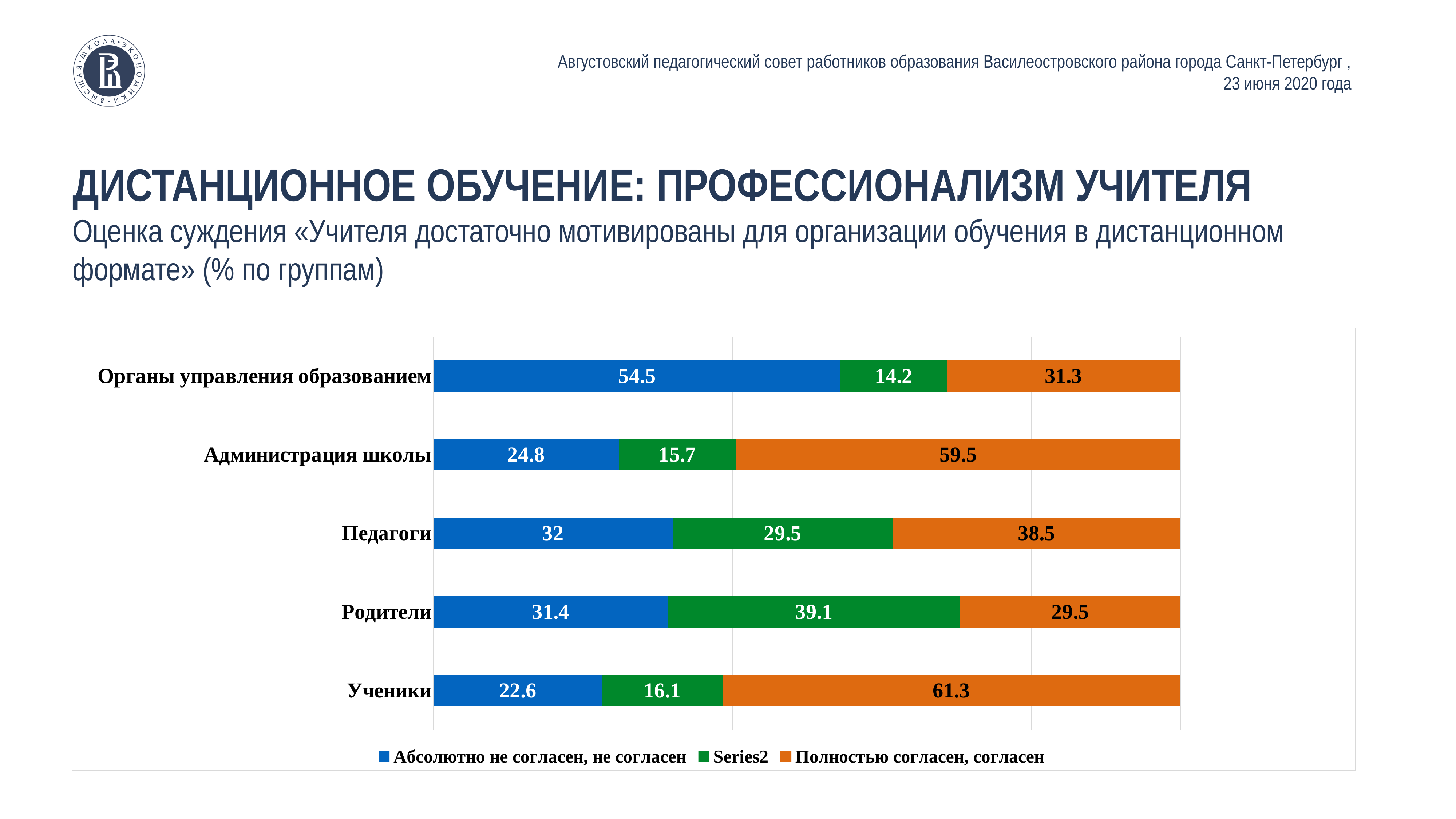
What is the label of the second (green) series in the legend? Series2 What is the Series2 value for Родители? 39.1 What is the value for Ученики in the series «Полностью согласен, согласен»? 61.3 Which group has the highest value in the series «Полностью согласен, согласен»? Ученики Which is larger: the Series2 value for Педагоги or the Series2 value for Родители? Родители Which group has the lowest value in the series «Абсолютно не согласен, не согласен»? Ученики For Администрация школы, how much larger is the «Полностью согласен, согласен» value than the «Абсолютно не согласен, не согласен» value? 34.7 What kind of chart is shown on the slide? Stacked bar chart How many groups (categories) are shown on the chart? 5 What is the value for Органы управления образованием in the series «Абсолютно не согласен, не согласен»? 54.5 How many series does the legend list? 3 What is the total of the stacked bar for Педагоги? 100